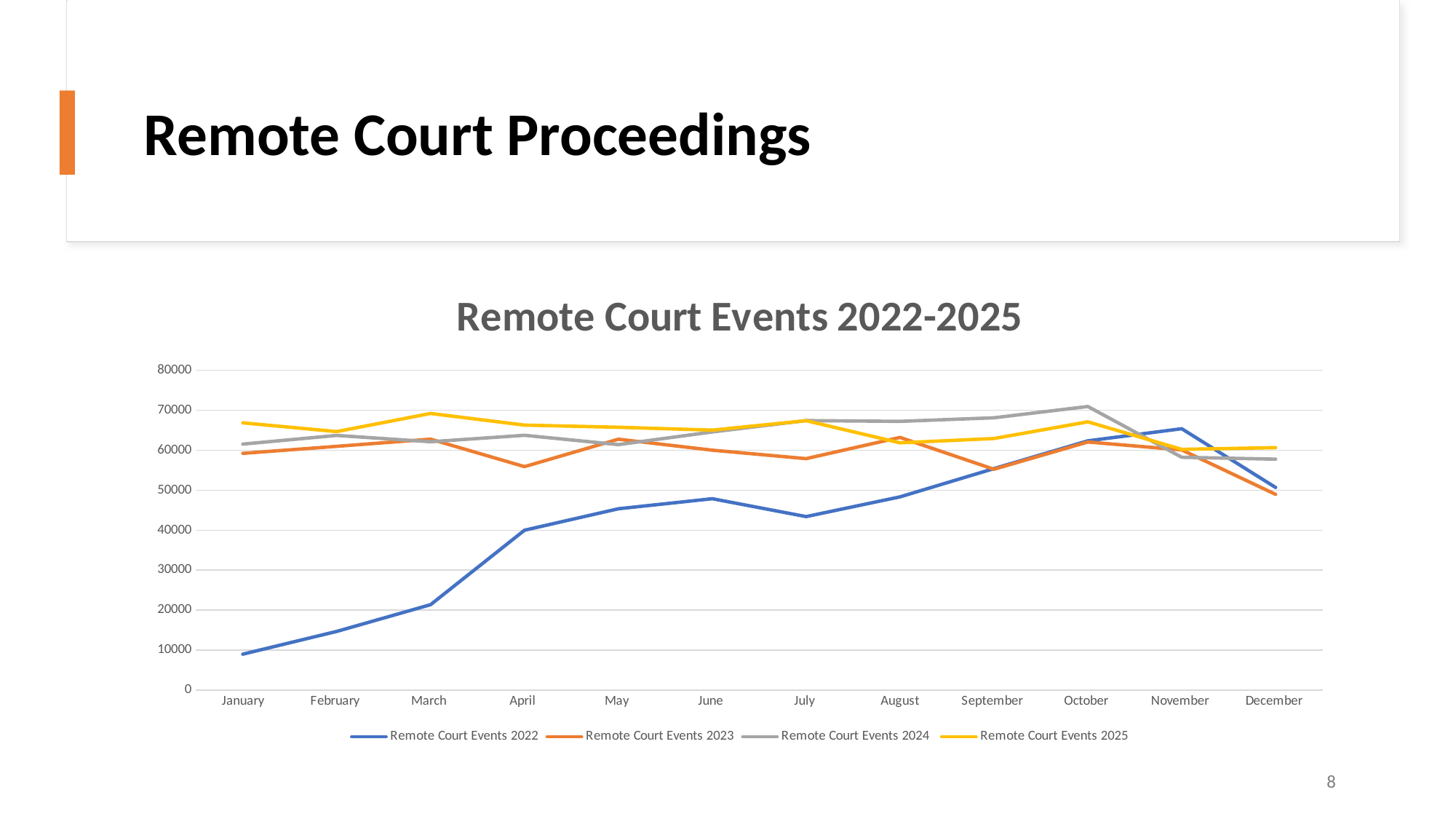
Does the Remote Court Events 2022 line rise or fall from January to April? rise In which month is Remote Court Events 2024 highest? October How many months are shown along the x axis? 12 Is the value for Remote Court Events 2023 in April greater or less than 60000? less What kind of chart is shown on the slide? line chart In which month is Remote Court Events 2023 lowest? December Is the value for Remote Court Events 2024 in October greater or less than 60000? greater Is the value for Remote Court Events 2022 in April greater or less than 30000? greater In which month is Remote Court Events 2022 lowest? January What is the title of the chart? Remote Court Events 2022-2025 How many series does the legend list? 4